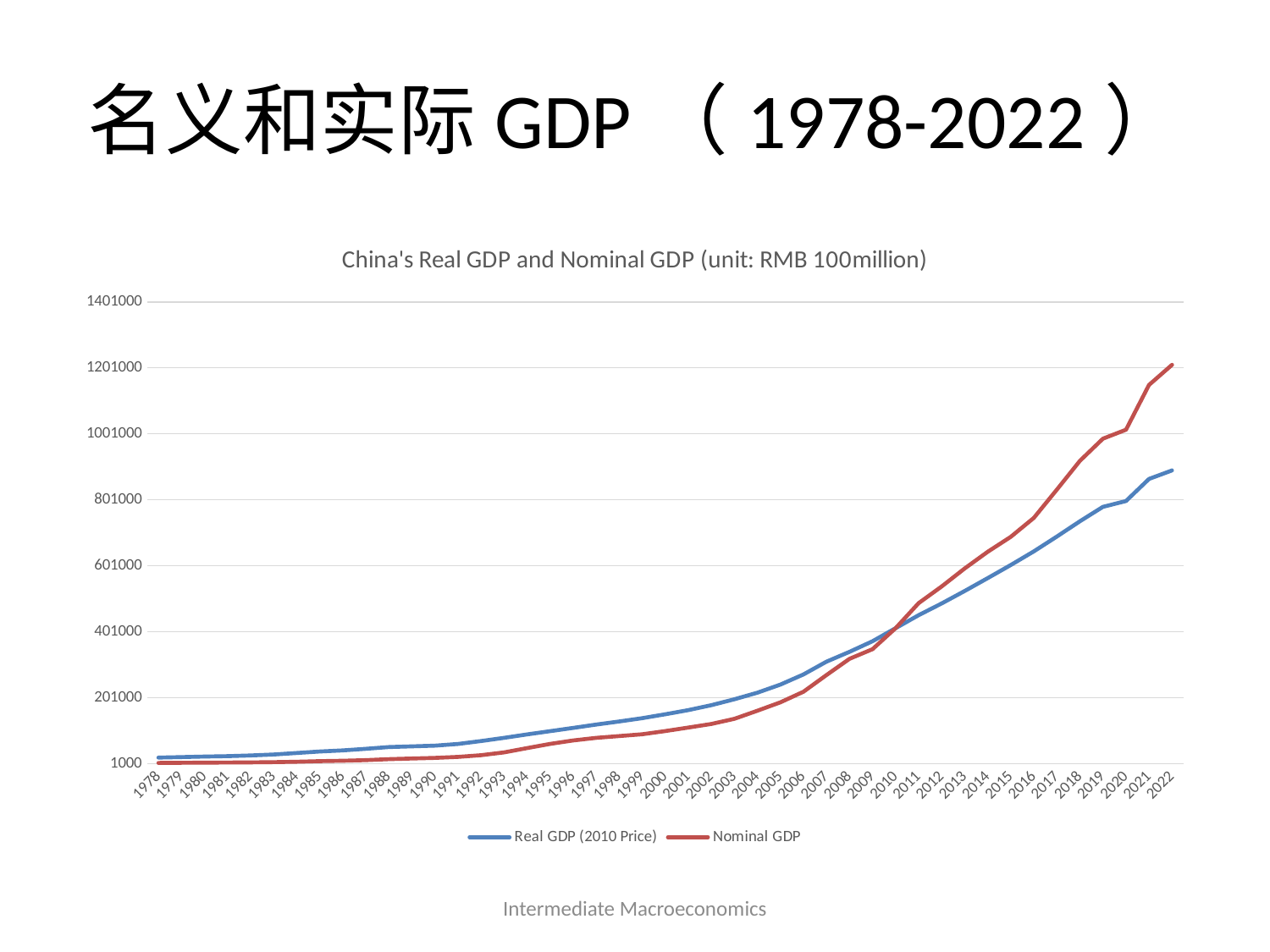
In which year is Real GDP (2010 Price) lowest? 1978 What is the title of the chart? China's Real GDP and Nominal GDP (unit: RMB 100million) Is the value for Nominal GDP in 2022 greater or less than 1001000? greater What kind of chart is shown on the slide? Line chart In 2022, which series is larger, Real GDP (2010 Price) or Nominal GDP? Nominal GDP In which year is Nominal GDP highest? 2022 Is the value for Real GDP (2010 Price) in 2022 greater or less than 1001000? less Do the Nominal GDP values rise or fall from 1978 to 2022? Rise In 2000, which series is larger, Real GDP (2010 Price) or Nominal GDP? Real GDP (2010 Price) How many years are plotted along the x axis? 45 How many series does the legend list? 2